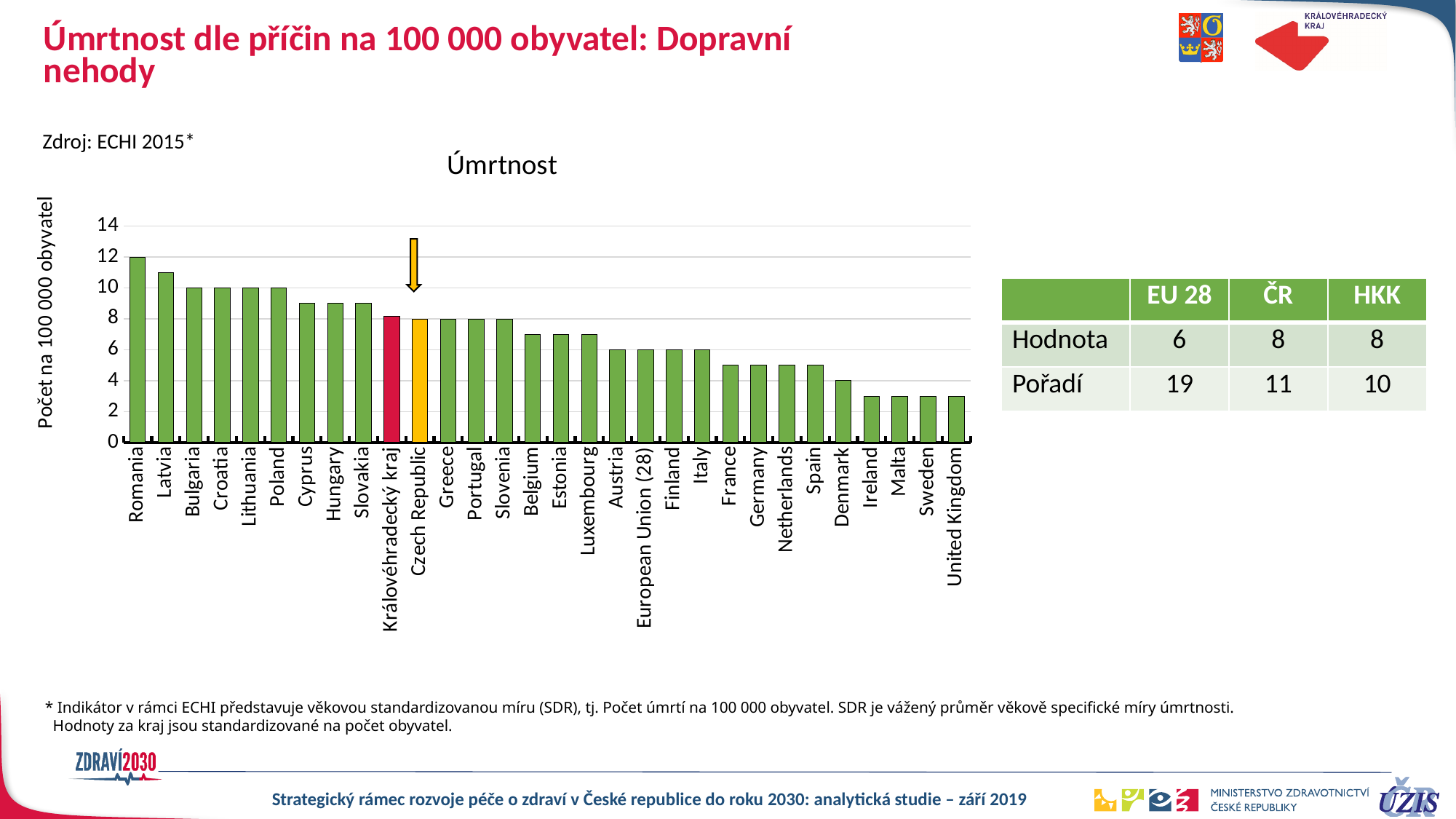
What is the title of the chart? Úmrtnost Is the value for Latvia greater or less than 10? greater Is the value for Cyprus greater or less than 10? less Which bar is coloured red in the chart? Královéhradecký kraj How many categories (bars) are plotted in the chart? 30 Is the value for Belgium greater or less than 8? less What kind of chart is shown on the slide? bar chart Which country has the highest mortality rate in the chart? Romania Which bar is higher, Poland or Spain? Poland Do the values rise or fall moving from left to right along the x axis? fall